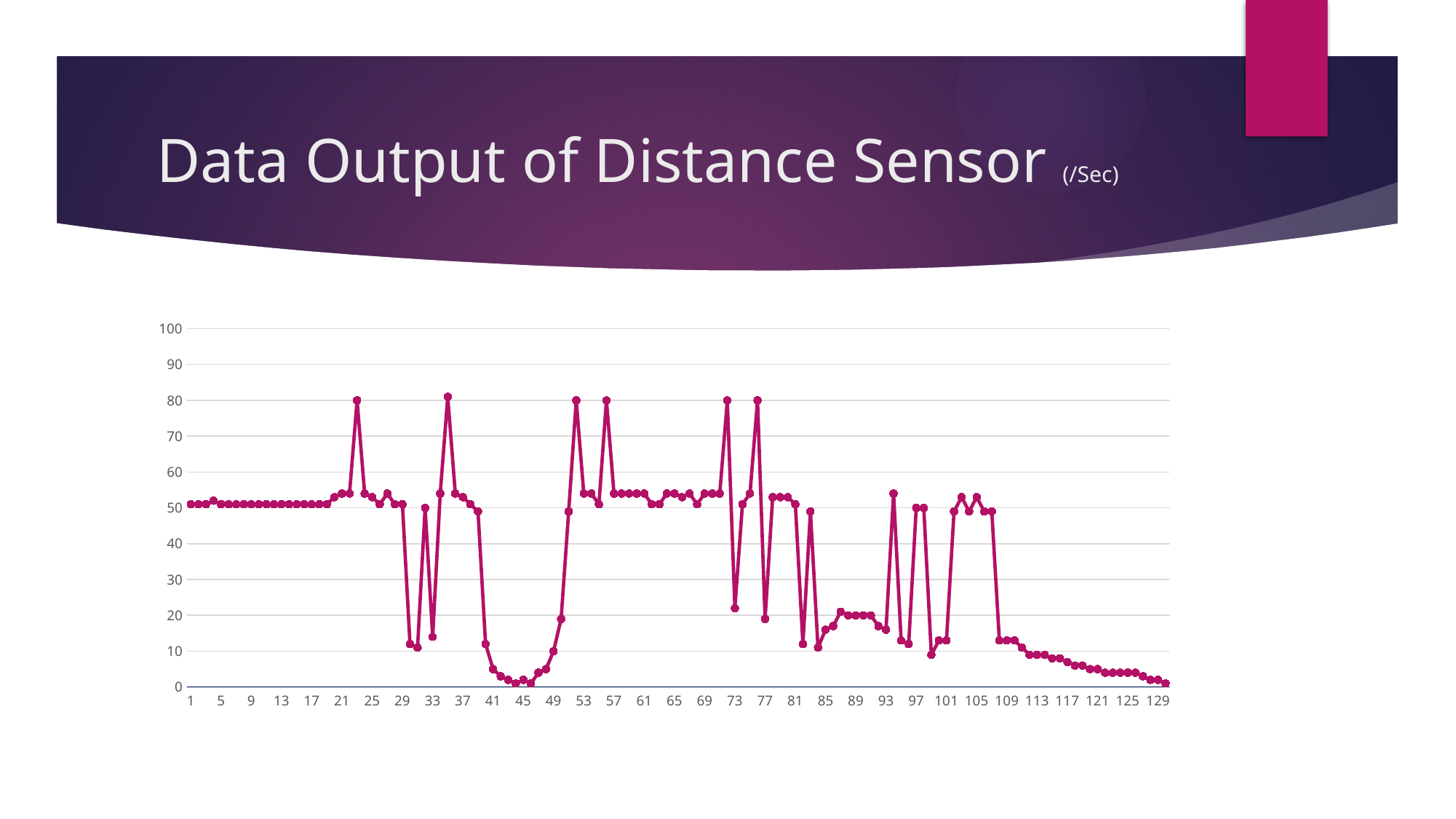
Is the value at x = 89 greater or less than 30? less What is the title of the slide's chart? Data Output of Distance Sensor What kind of chart is shown on the slide? line chart From x = 109 to x = 129, do the values generally rise or fall? fall Is the value at x = 45 greater or less than 10? less Which is larger, the value at x = 23 or the value at x = 45? x = 23 Is the value at x = 23 greater or less than 70? greater What is the highest value shown on the chart's vertical axis? 100 Which is larger, the value at x = 1 or the value at x = 129? x = 1